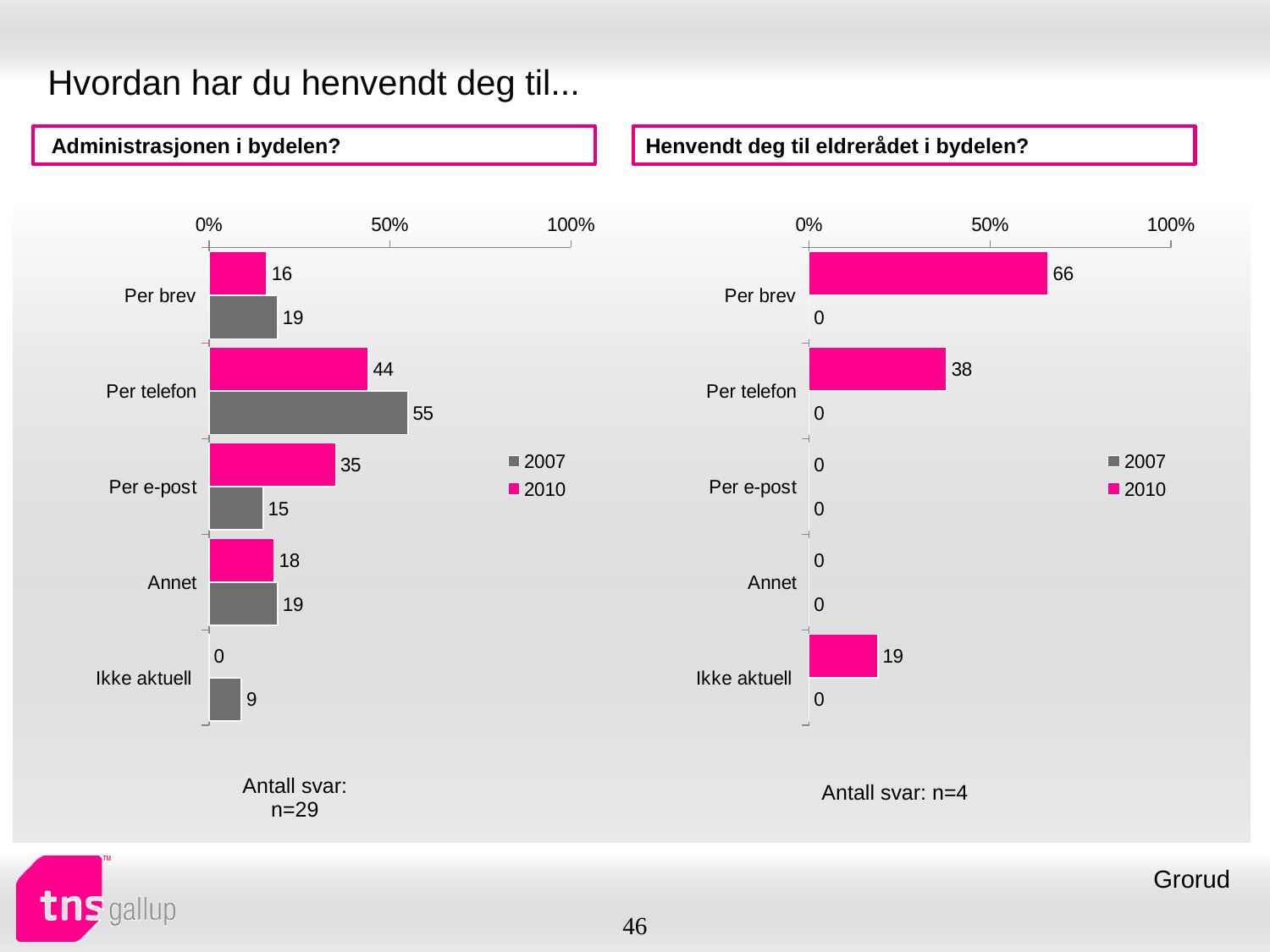
In the 'Henvendt deg til eldrerådet i bydelen?' chart, which category has the highest 2010 value? Per brev In the 'Administrasjonen i bydelen?' chart, which category has the lowest 2007 value? Ikke aktuell In the 'Administrasjonen i bydelen?' chart, what is the 2007 value for Per telefon? 55 How many series does the legend of the 'Henvendt deg til eldrerådet i bydelen?' chart list? 2 How many categories are shown in the 'Administrasjonen i bydelen?' chart? 5 In the 'Henvendt deg til eldrerådet i bydelen?' chart, what is the 2010 value for Ikke aktuell? 19 In the 'Henvendt deg til eldrerådet i bydelen?' chart, what is the 2010 value for Per brev? 66 In the 'Henvendt deg til eldrerådet i bydelen?' chart, is the 2010 value for Per brev greater or less than 50%? greater In the 'Administrasjonen i bydelen?' chart, which is larger for Per e-post: the 2007 value or the 2010 value? 2010 In the 'Administrasjonen i bydelen?' chart, which category has the highest 2010 value? Per telefon In the 'Administrasjonen i bydelen?' chart, what is the 2010 value for Per e-post? 35 In the 'Administrasjonen i bydelen?' chart, what is the difference between the 2007 and 2010 values for Per telefon? 11